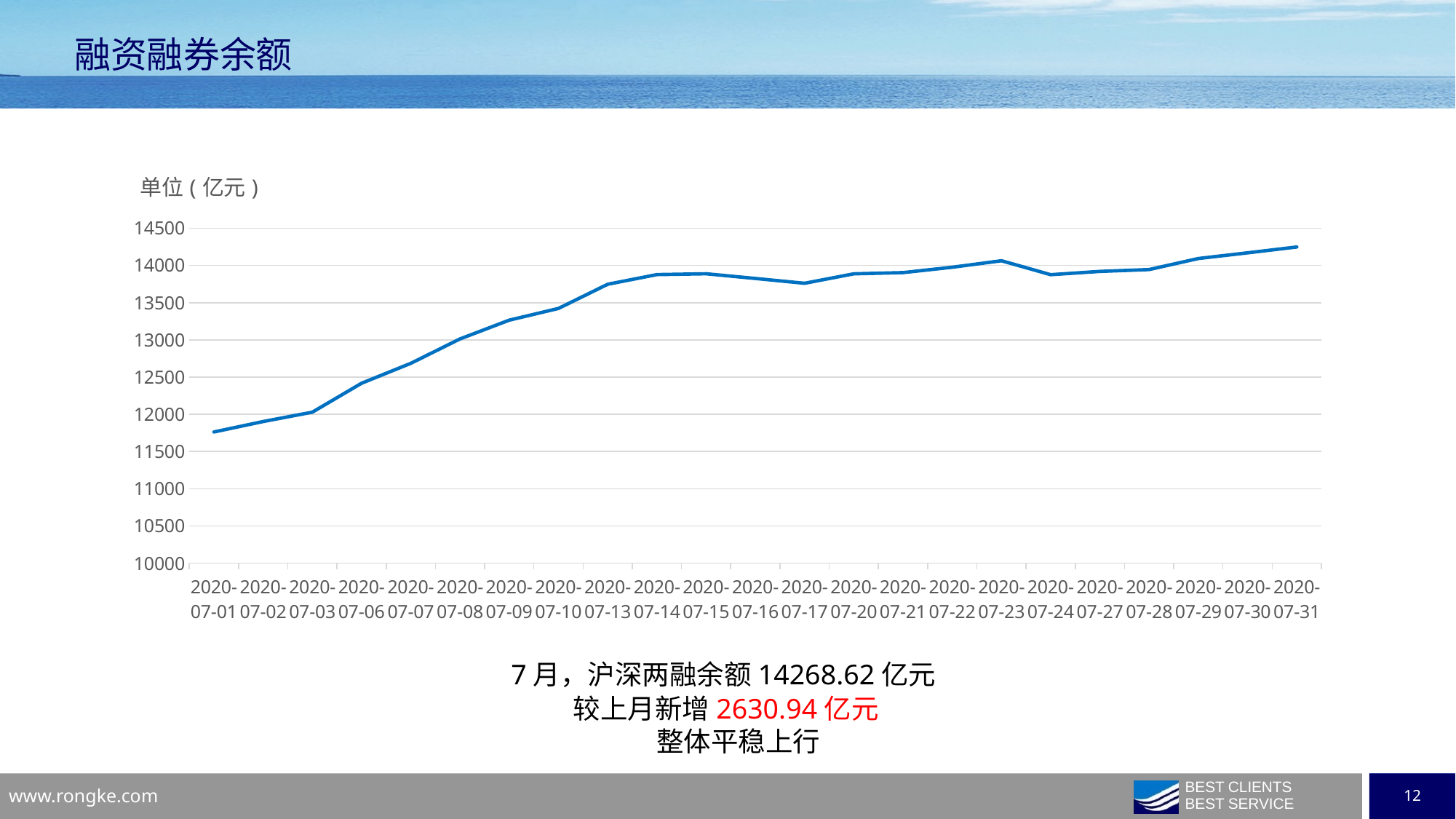
Which is larger, the value for 2020-07-10 or the value for 2020-07-13? 2020-07-13 Is the value for 2020-07-31 greater or less than 14000? greater Which is larger, the value for 2020-07-23 or the value for 2020-07-24? 2020-07-23 How many dates are plotted along the x axis of the chart? 23 Is the value for 2020-07-13 greater or less than 13500? greater What kind of chart is shown on the slide? line chart Which date has the lowest value on the chart? 2020-07-01 Overall, do the values rise or fall from 2020-07-01 to 2020-07-31? rise Is the value for 2020-07-01 greater or less than 12000? less Which date has the highest value on the chart? 2020-07-31 What unit is stated above the chart? 亿元